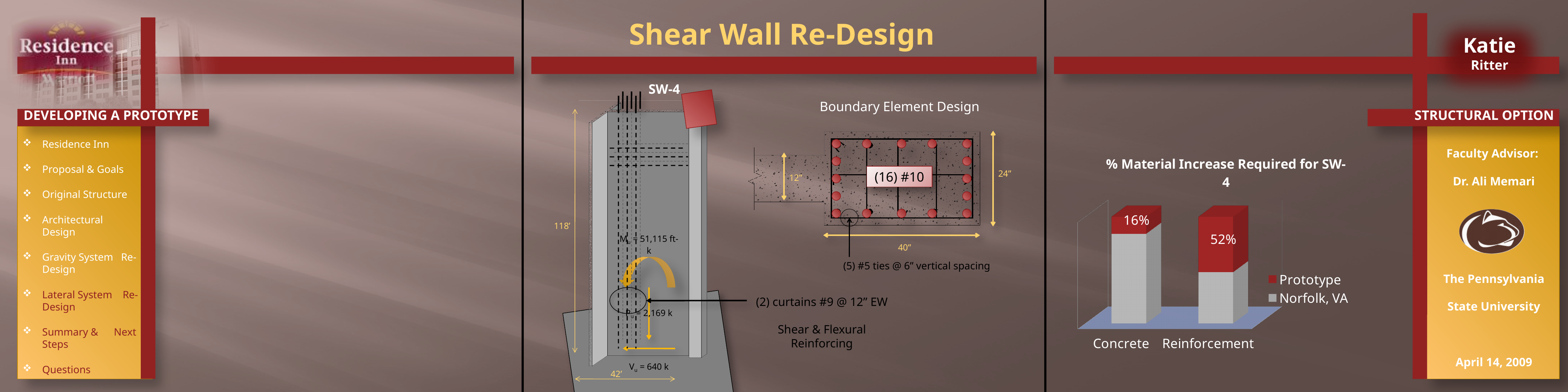
How many series does the chart's legend list? 2 What is the chart's title? % Material Increase Required for SW-4 Which series is shown in red in the chart? Prototype Which category has the higher Prototype value? Reinforcement What kind of chart is shown on the slide? bar chart What is the Prototype value for Reinforcement? 52% What is the Prototype value for Concrete? 16% Is the Prototype value larger for Concrete or for Reinforcement? Reinforcement How many categories are shown on the x axis of the chart? 2 Which series is shown in grey in the chart? Norfolk, VA Which category has the lower Prototype value? Concrete What is the difference between the Prototype values for Reinforcement and Concrete? 36%